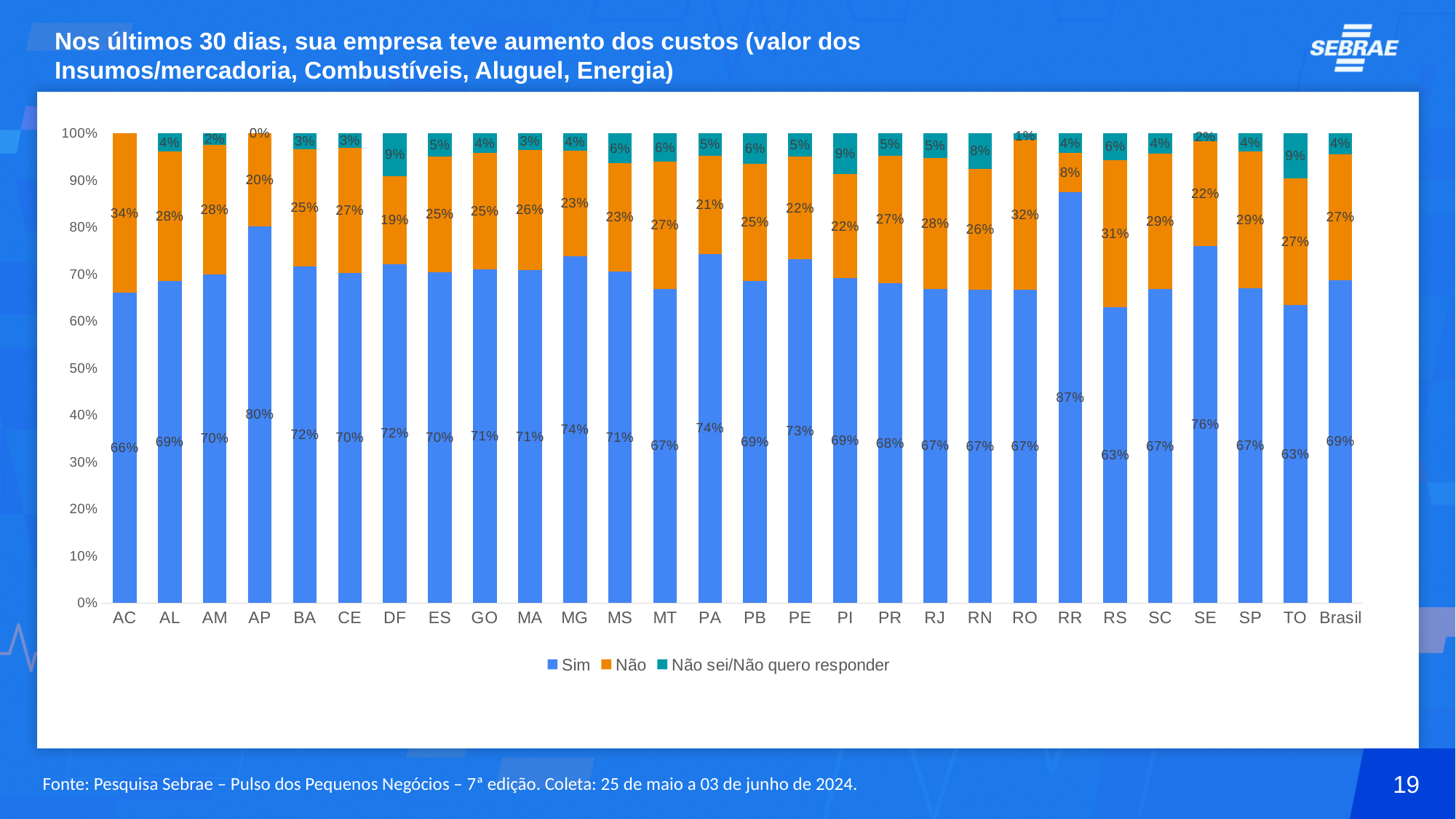
What is the value of the Sim series for RR? 87% What kind of chart is shown on the slide? Stacked bar chart How many series does the legend list? 3 What is the value of the Não series for AC? 34% Which category has the lowest value for the Não series? RR What is the difference between the Sim values for AP and AC? 14% How many categories are shown on the x axis? 28 Which category has the highest value for the Sim series? RR Which has a larger Sim value, SE or RS? SE What colour represents the Não series? Orange What is the value of the Não sei/Não quero responder series for DF? 9% What is the value of the Sim series for Brasil? 69%